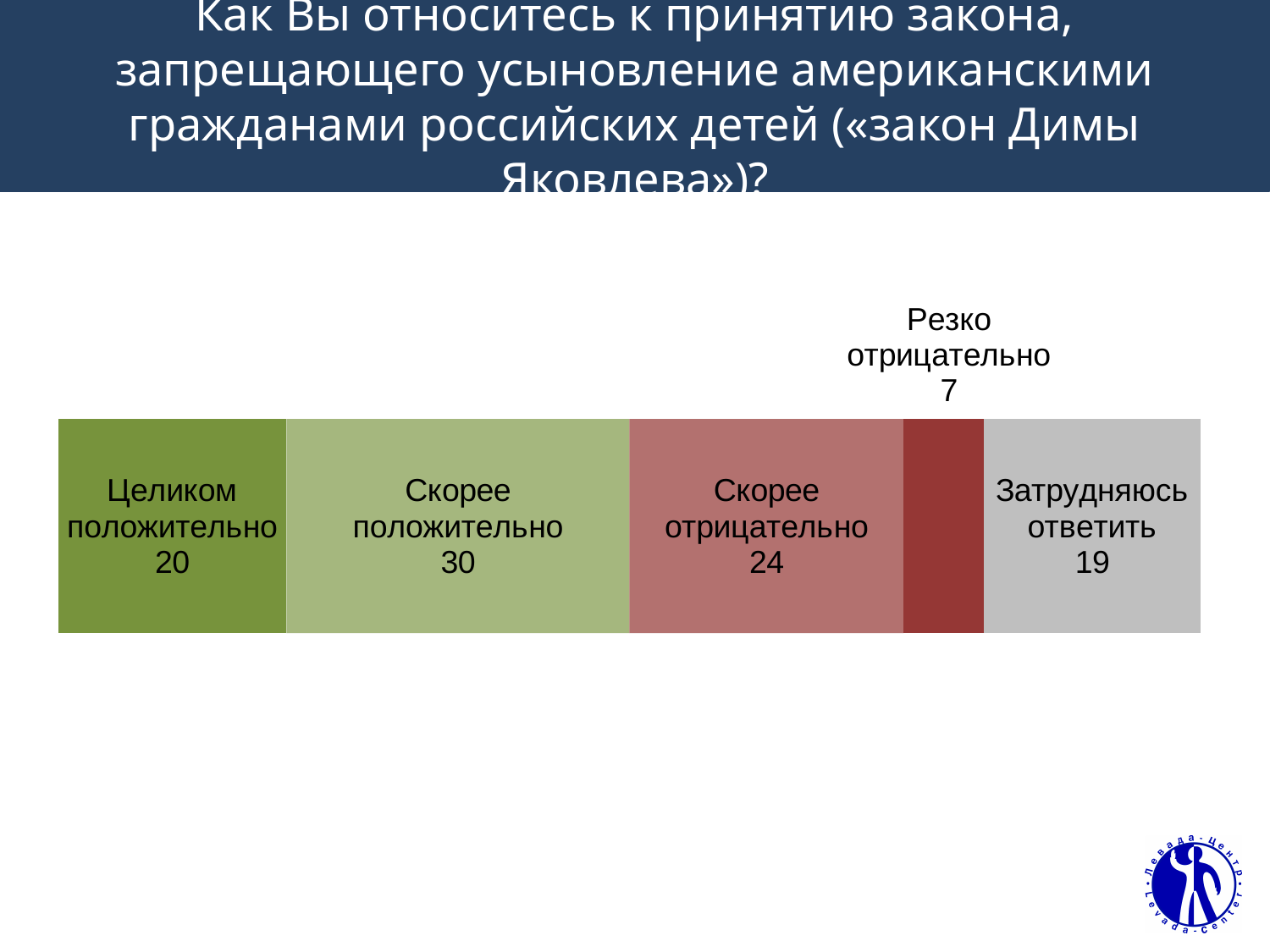
What is the total of all segments in the stacked bar? 100 Which response category has the highest value? Скорее положительно What is the value for «Резко отрицательно»? 7 What kind of chart is shown on the slide? Stacked bar chart What is the value for «Скорее положительно»? 30 How many response categories are shown in the bar? 5 Which is larger, «Целиком положительно» or «Затрудняюсь ответить»? Целиком положительно What is the difference between «Скорее положительно» and «Скорее отрицательно»? 6 What is the difference between «Целиком положительно» and «Резко отрицательно»? 13 What colour is the «Резко отрицательно» segment? Dark red What is the value for «Затрудняюсь ответить»? 19 Which response category has the lowest value? Резко отрицательно